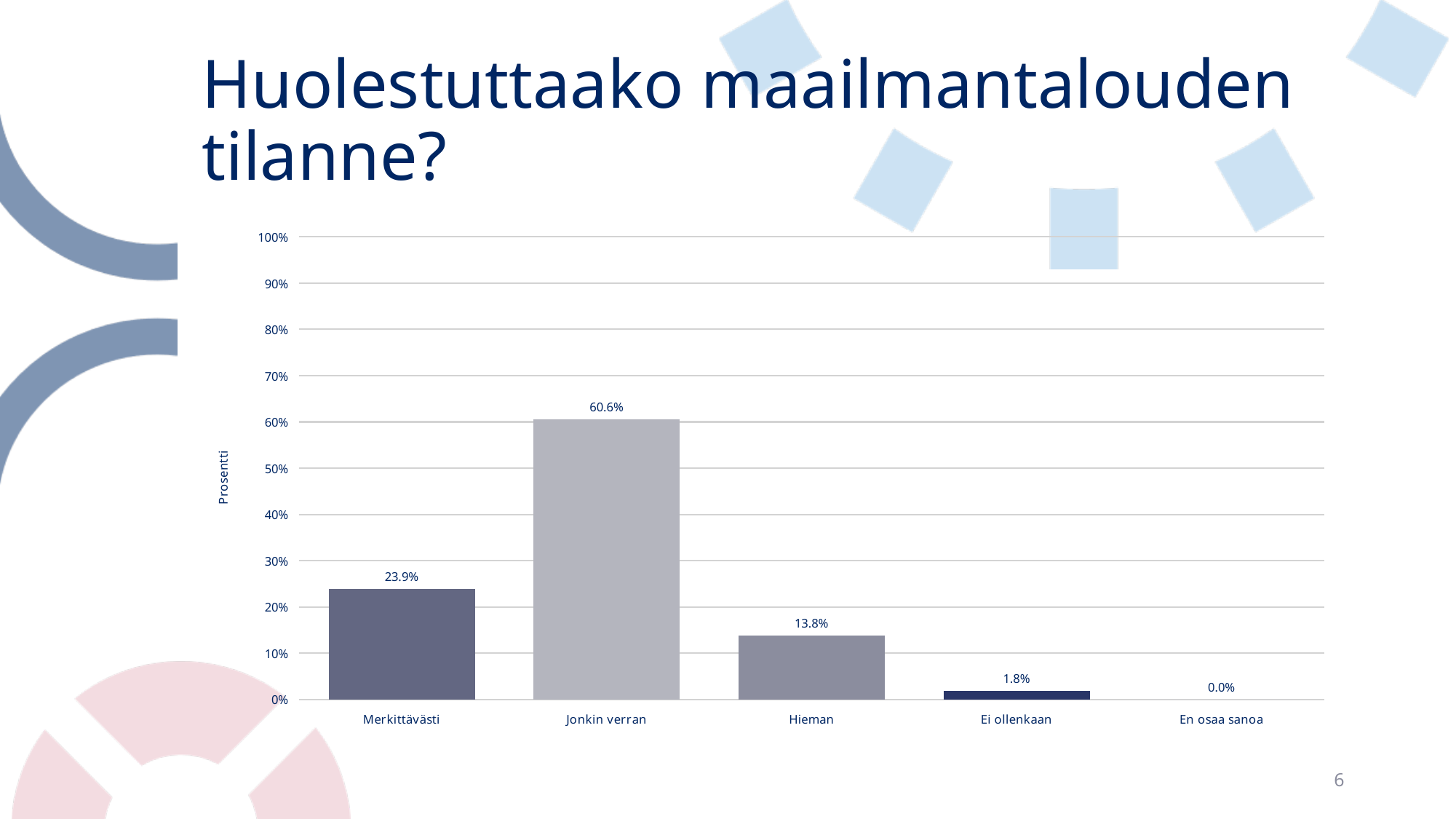
What is the value for Merkittävästi? 23.9% What is the value for Hieman? 13.8% Which is larger, the value for Merkittävästi or the value for Hieman? Merkittävästi What is the label of the vertical axis? Prosentti Which category has the lowest value? En osaa sanoa What is the value for Ei ollenkaan? 1.8% What is the difference between the values for Jonkin verran and Merkittävästi? 36.7% Is the value for Jonkin verran greater or less than 50%? greater How many categories are shown on the x axis? 5 What kind of chart is shown on the slide? bar chart What is the value for Jonkin verran? 60.6% Which category has the highest value? Jonkin verran